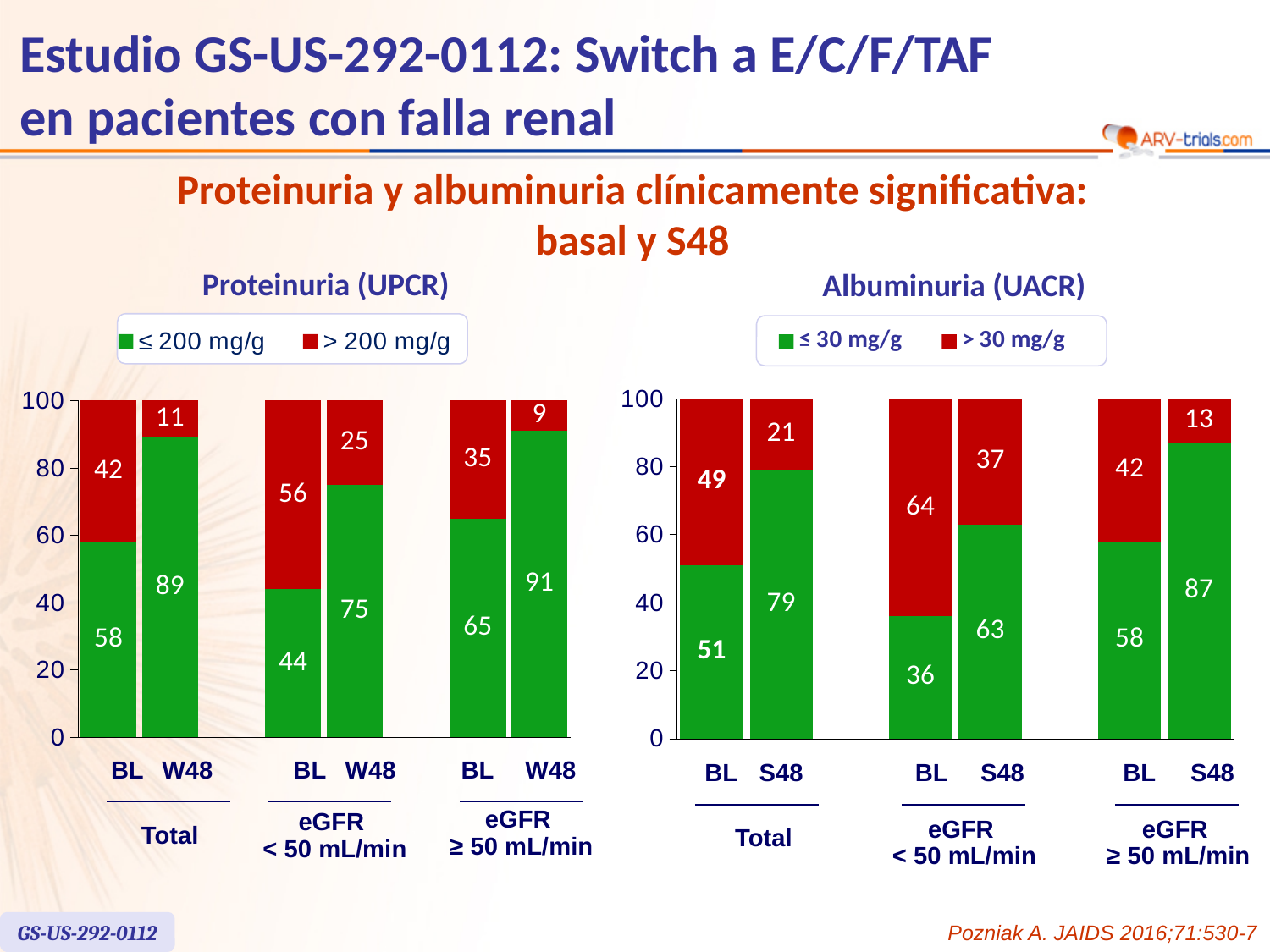
How many series does the legend of the Albuminuria (UACR) chart list? 2 How many stacked bars are plotted in the Proteinuria (UPCR) chart? 6 In the Proteinuria (UPCR) chart, what is the value of the ≤ 200 mg/g segment for the Total BL bar? 58 What type of chart is the Proteinuria (UPCR) chart? Stacked bar chart In the Proteinuria (UPCR) chart, which bar has the largest ≤ 200 mg/g segment? eGFR ≥ 50 mL/min W48 In the Albuminuria (UACR) chart, which bar has the smallest ≤ 30 mg/g segment? eGFR < 50 mL/min BL In the Albuminuria (UACR) chart, what is the value of the > 30 mg/g segment for the Total S48 bar? 21 In the Proteinuria (UPCR) chart, what is the value of the > 200 mg/g segment for the eGFR < 50 mL/min BL bar? 56 In the Proteinuria (UPCR) chart, what is the difference between the ≤ 200 mg/g values for the Total W48 and Total BL bars? 31 In the Albuminuria (UACR) chart, is the > 30 mg/g segment larger for the eGFR < 50 mL/min BL bar or the eGFR ≥ 50 mL/min BL bar? eGFR < 50 mL/min BL In the Albuminuria (UACR) chart, what is the total of the stacked bar for eGFR < 50 mL/min S48? 100 In the Albuminuria (UACR) chart, what is the value of the ≤ 30 mg/g segment for the eGFR ≥ 50 mL/min S48 bar? 87